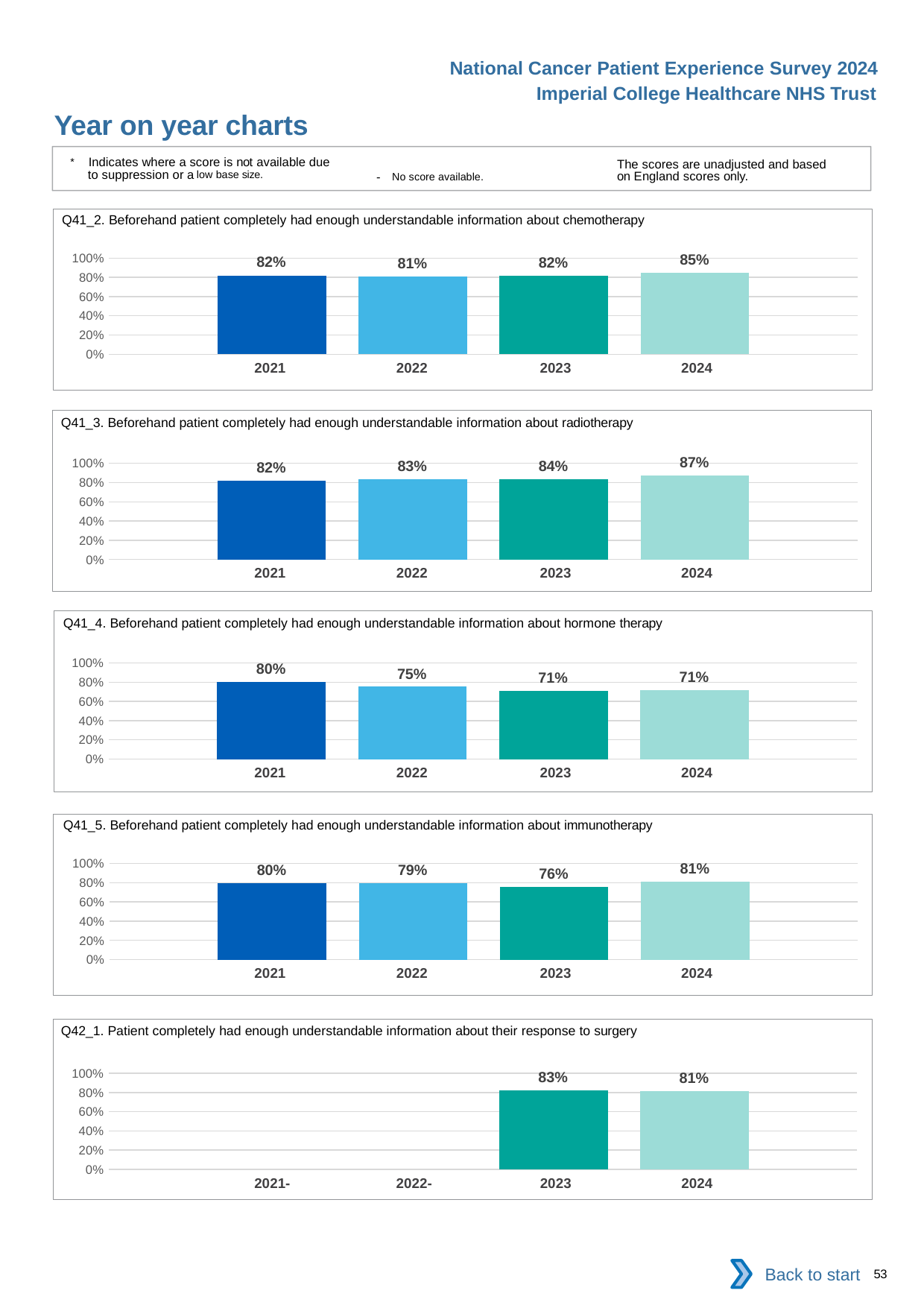
In the Q42_1 surgery chart, how many years have a bar plotted? 2 In the Q41_2 chemotherapy chart, which is larger, the 2022 value or the 2024 value? 2024 In the Q41_5 immunotherapy chart, what is the value for 2022? 79% In the Q41_2 chemotherapy chart, what is the value for 2024? 85% In the Q41_4 hormone therapy chart, what is the difference between the 2021 and 2024 values? 9 percentage points In the Q41_5 immunotherapy chart, which year has the lowest value? 2023 How many charts are shown on the slide? 5 In the Q42_1 surgery chart, what is the value for 2023? 83% In the Q41_3 radiotherapy chart, which year has the highest value? 2024 In the Q41_4 hormone therapy chart, do the values rise or fall from 2021 to 2023? fall In the Q41_3 radiotherapy chart, what is the difference between the 2024 and 2021 values? 5 percentage points What type of chart is the Q41_3 radiotherapy chart? bar chart